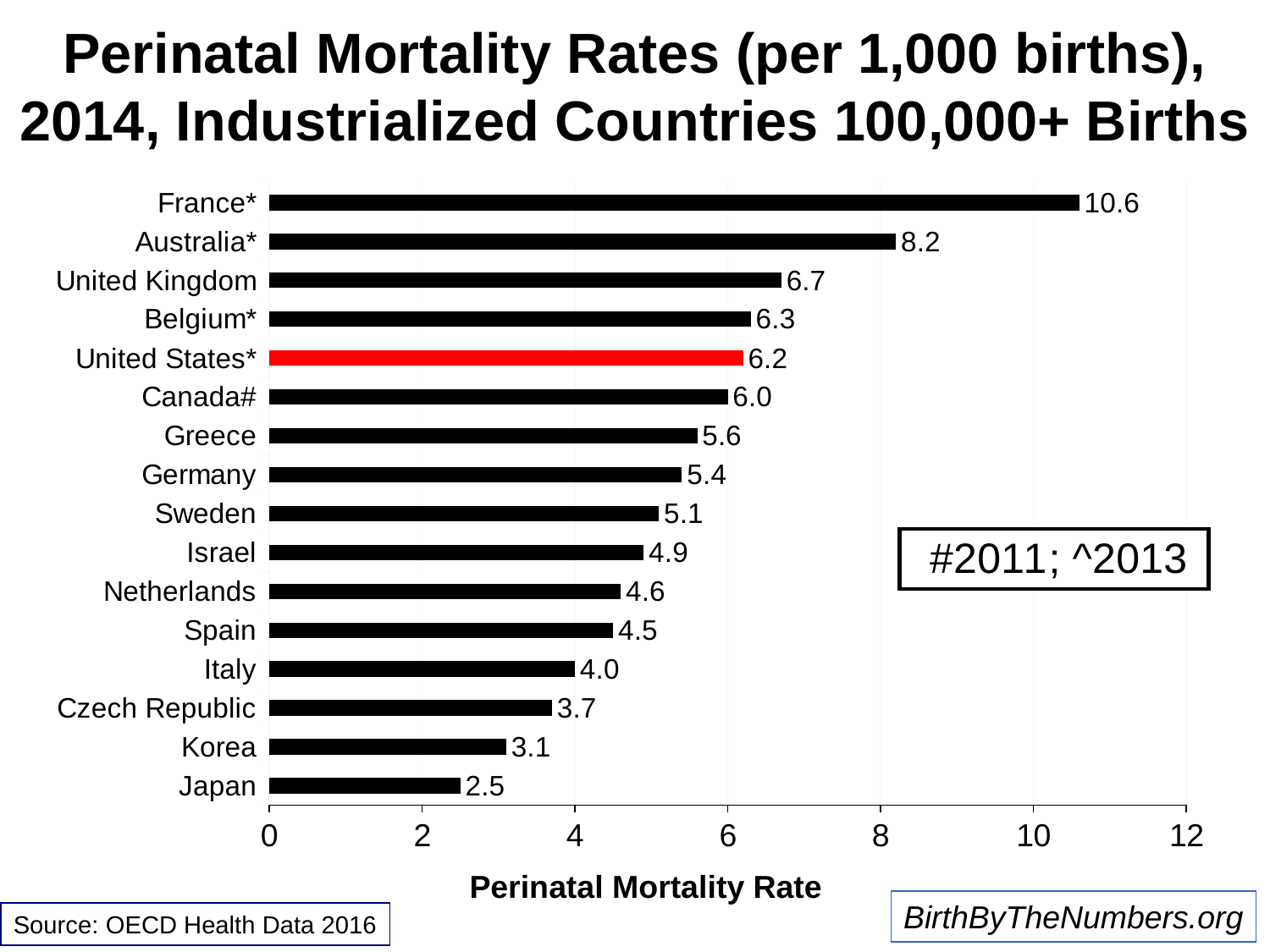
Which has a higher perinatal mortality rate, the United Kingdom or Canada#? United Kingdom What is the perinatal mortality rate shown for the United States*? 6.2 Which country's bar is coloured red on the chart? United States* What is the difference between the perinatal mortality rates of France* and Australia*? 2.4 Is the value for Sweden greater or less than 4? greater How many countries are shown on the chart? 16 What is the perinatal mortality rate shown for Japan? 2.5 What kind of chart is shown on the slide? Bar chart Which country has the lowest perinatal mortality rate on the chart? Japan What is the perinatal mortality rate shown for Germany? 5.4 Which country has the highest perinatal mortality rate on the chart? France* What is the label of the horizontal axis? Perinatal Mortality Rate